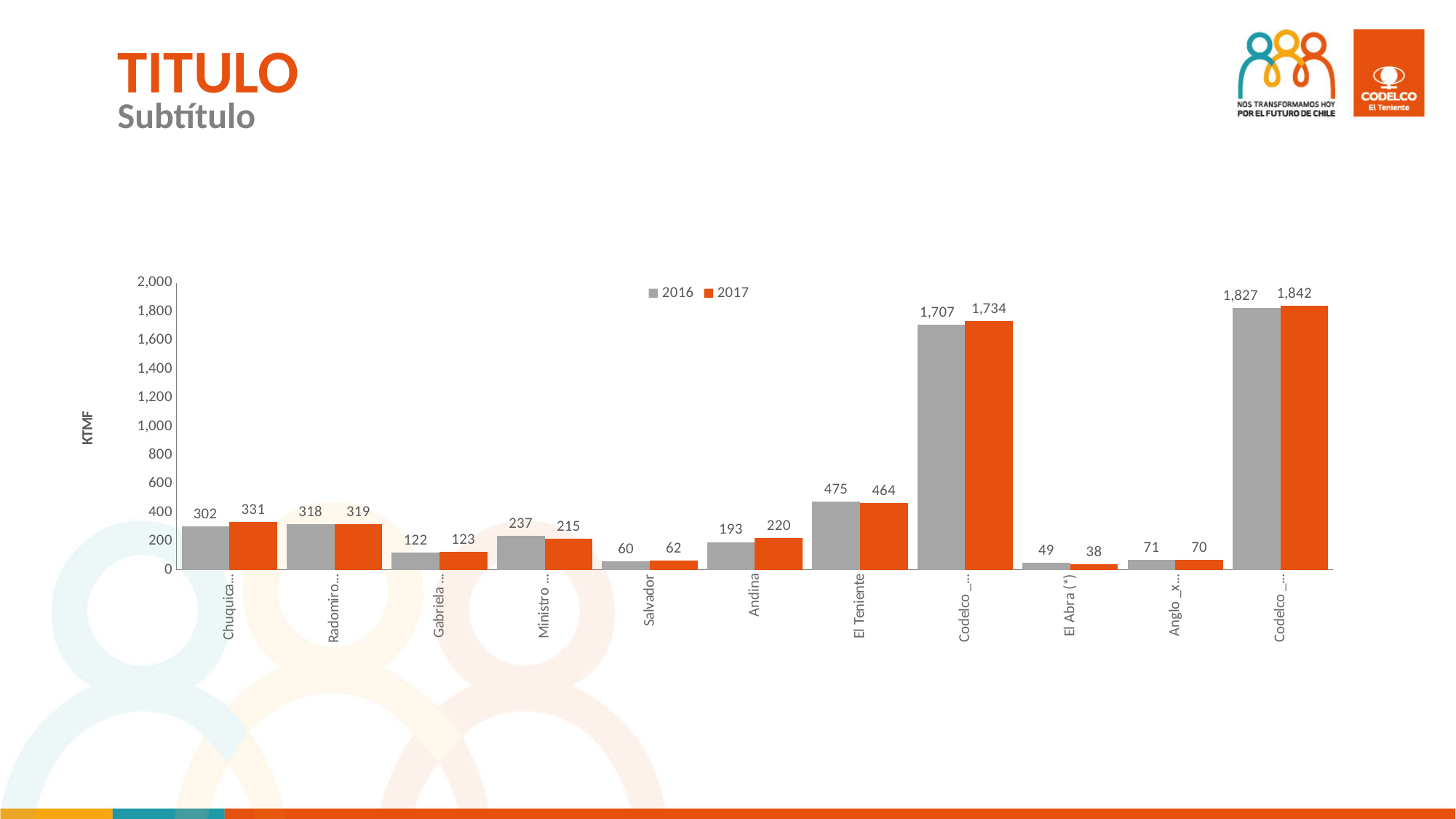
How many categories are shown on the x axis? 11 What is the 2017 value for El Abra (*)? 38 What is the label on the vertical axis? KTMF What is the 2016 value for El Teniente? 475 By how much did the value for Andina increase from 2016 to 2017? 27 Which category has the lowest 2017 value? El Abra (*) What is the 2016 value for Salvador? 60 What is the 2017 value for Andina? 220 What is the difference between the 2016 and 2017 values for El Teniente? 11 What is the highest 2017 value shown on the chart? 1,842 For El Teniente, which year has the larger value, 2016 or 2017? 2016 How many series does the legend list? 2